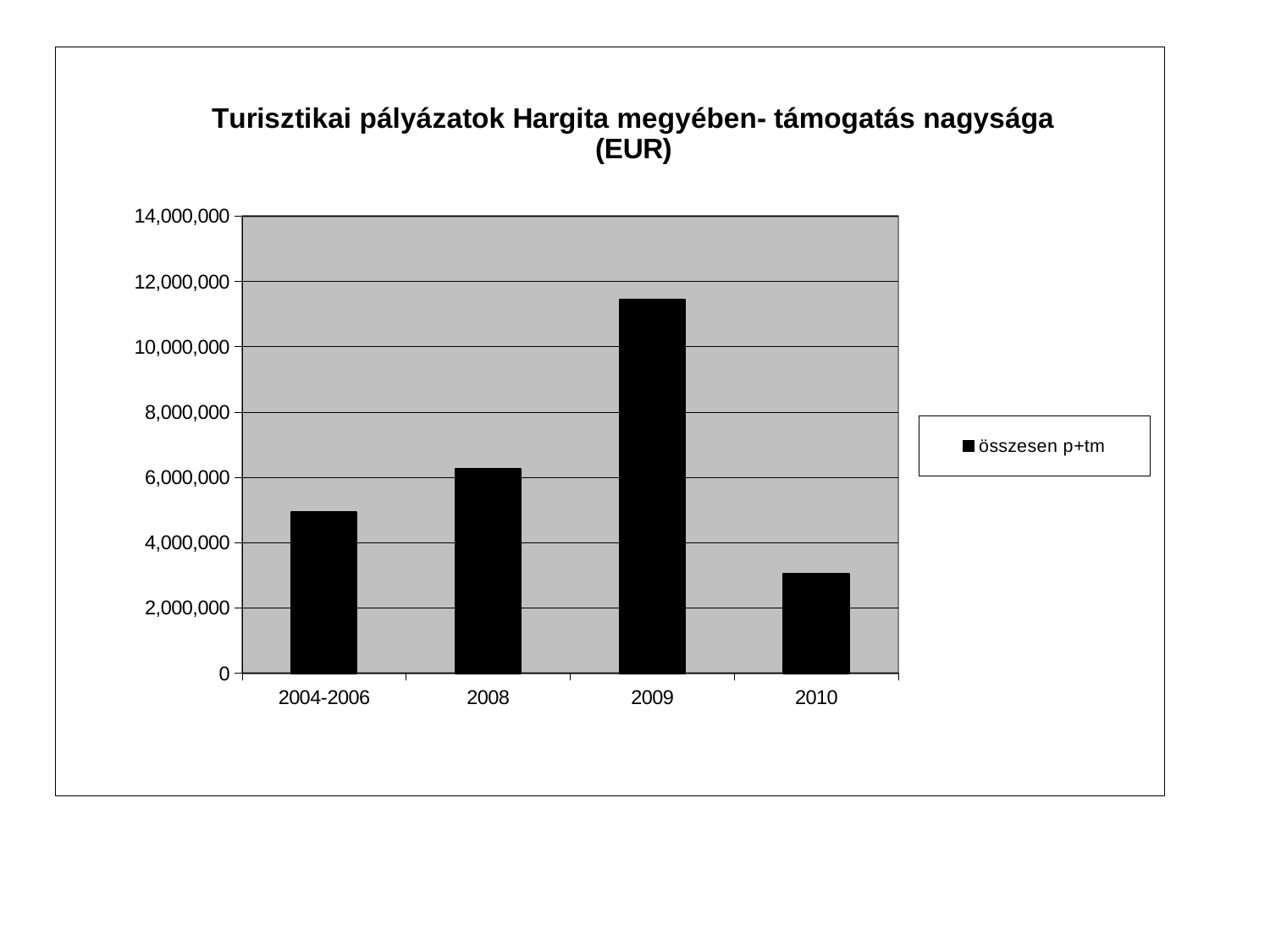
Is the value for 2008 greater or less than 8,000,000? less What kind of chart is shown on the slide? bar chart Is the value for 2009 greater or less than 10,000,000? greater Which category has the highest value? 2009 Is the value for 2010 greater or less than 4,000,000? less Which category has the lowest value? 2010 What is the title of the chart? Turisztikai pályázatok Hargita megyében- támogatás nagysága (EUR) How many series does the legend list? 1 Which is larger, the value for 2008 or the value for 2004-2006? 2008 What is the name of the series shown in the legend? összesen p+tm How many categories are shown on the x axis? 4